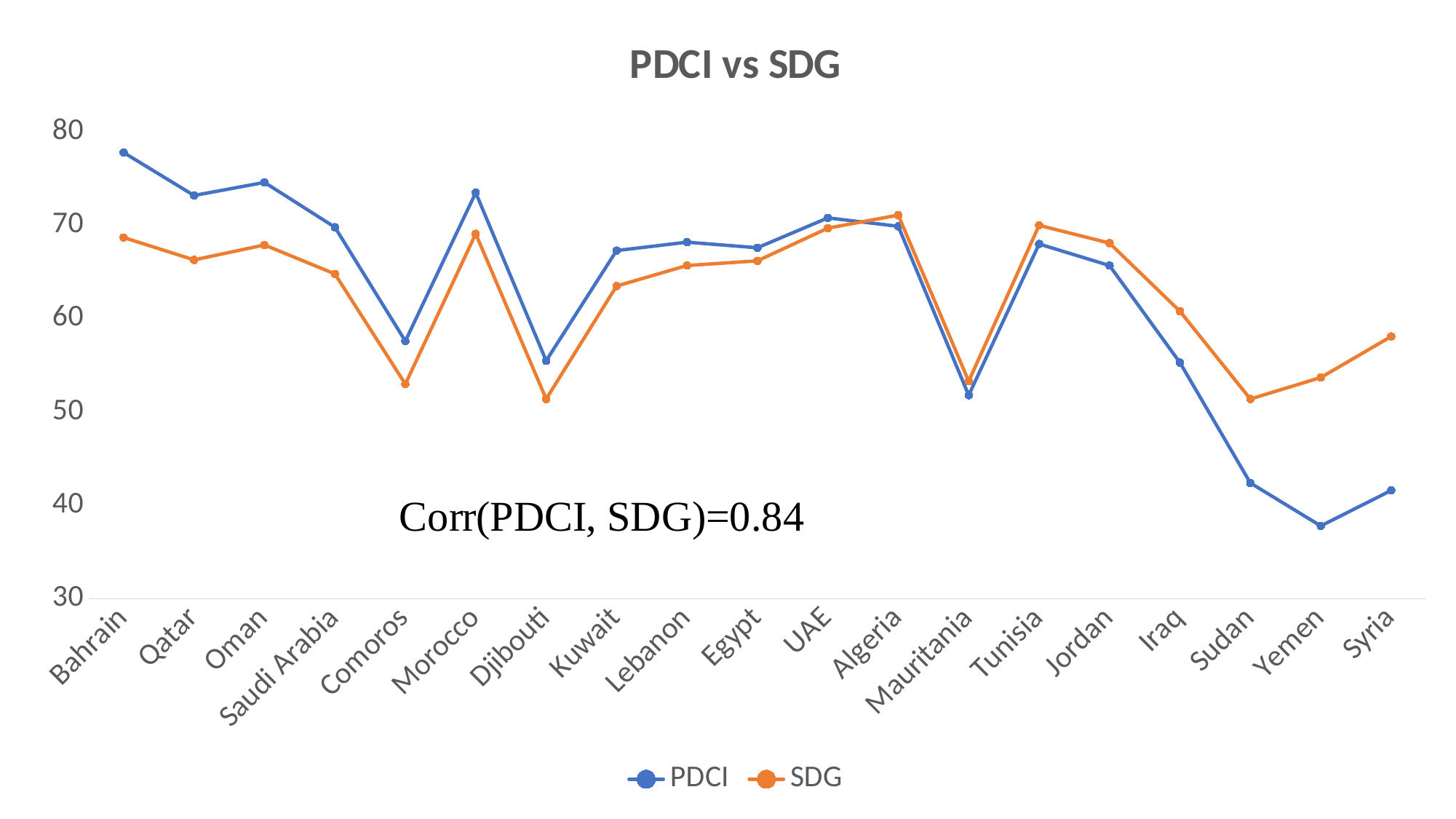
What kind of chart is shown on the slide? line chart How many series does the legend list? 2 Is the PDCI value for Bahrain greater or less than 70? greater For Sudan, which series has the larger value, PDCI or SDG? SDG Does the PDCI line rise or fall from Jordan to Yemen? fall Is the PDCI value for Yemen greater or less than 40? less How many countries are plotted along the x axis? 19 What correlation value between PDCI and SDG is printed on the chart? 0.84 Which country has the lowest PDCI value? Yemen Which country has the highest PDCI value? Bahrain For Bahrain, which series has the larger value, PDCI or SDG? PDCI